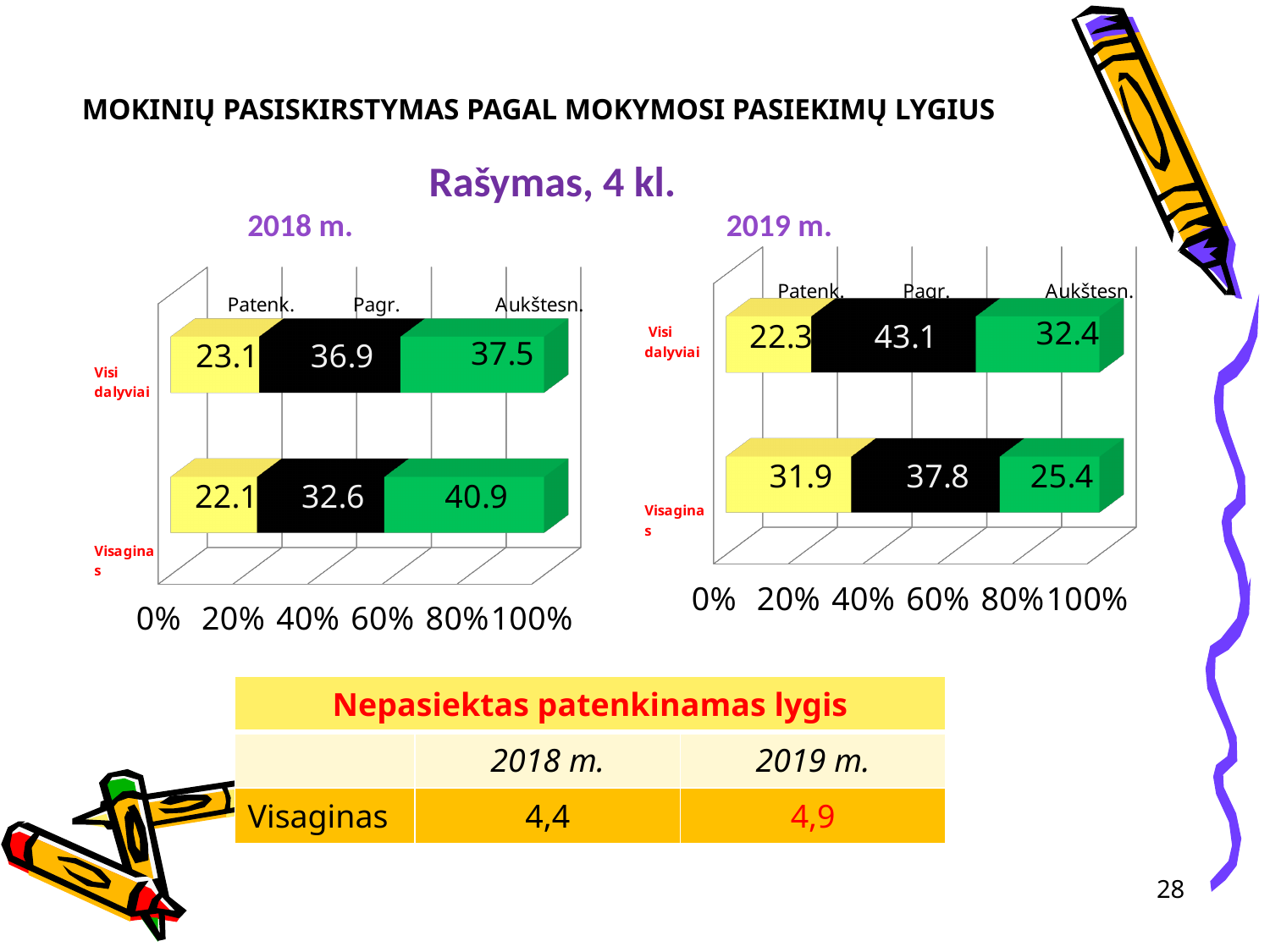
In the 2019 m. chart, what is the Patenk. value for Visaginas? 31.9 In the 2018 m. chart, what is the Pagr. value for Visi dalyviai? 36.9 In the 2019 m. chart, what is the difference between the Patenk. values for Visaginas and Visi dalyviai? 9.6 In the 2019 m. chart, which is larger for Visi dalyviai: Patenk. or Aukštesn.? Aukštesn. In the 2018 m. chart, what is the difference between the Aukštesn. values for Visaginas and Visi dalyviai? 3.4 How many categories are shown in the 2019 m. chart? 2 In the 2018 m. chart, which segment is smallest for Visi dalyviai? Patenk. In the 2019 m. chart, which segment is largest for Visaginas? Pagr. In the 2019 m. chart, what is the Pagr. value for Visi dalyviai? 43.1 In the 2018 m. chart, what is the Aukštesn. value for Visaginas? 40.9 What type of chart is the 2018 m. chart? Stacked bar chart